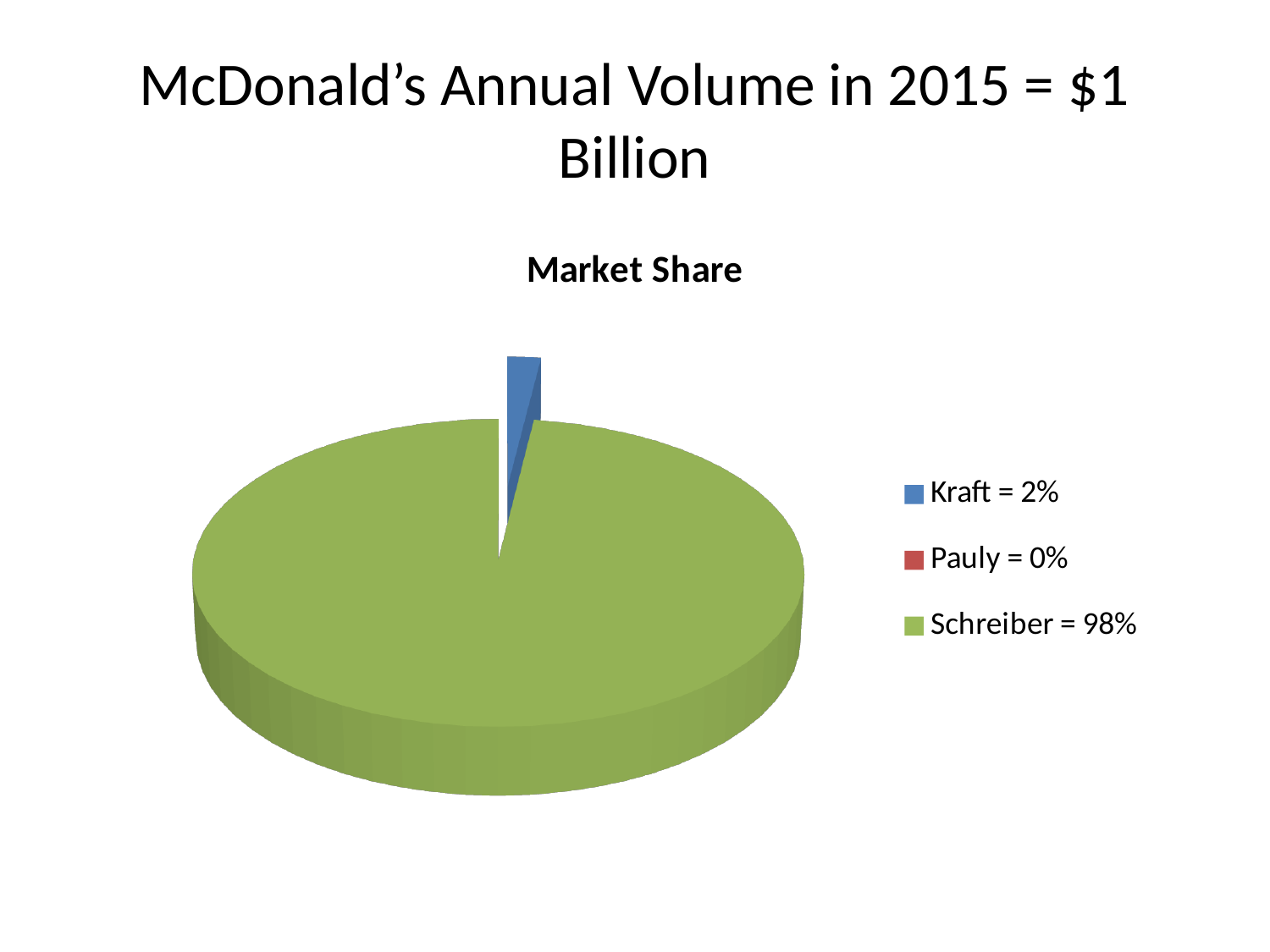
Which company has the smallest market share? Pauly What market share does the legend give for Kraft? 2% What market share does the legend give for Schreiber? 98% Which has a larger market share, Kraft or Schreiber? Schreiber What is the difference in market share between Schreiber and Kraft? 96% What kind of chart is shown on the slide? pie chart What is the chart's title? Market Share Which company has the largest market share? Schreiber How many companies are listed in the legend? 3 What colour is the slice representing Schreiber? green What market share does the legend give for Pauly? 0% What share of the pie does Kraft's slice represent? 2%